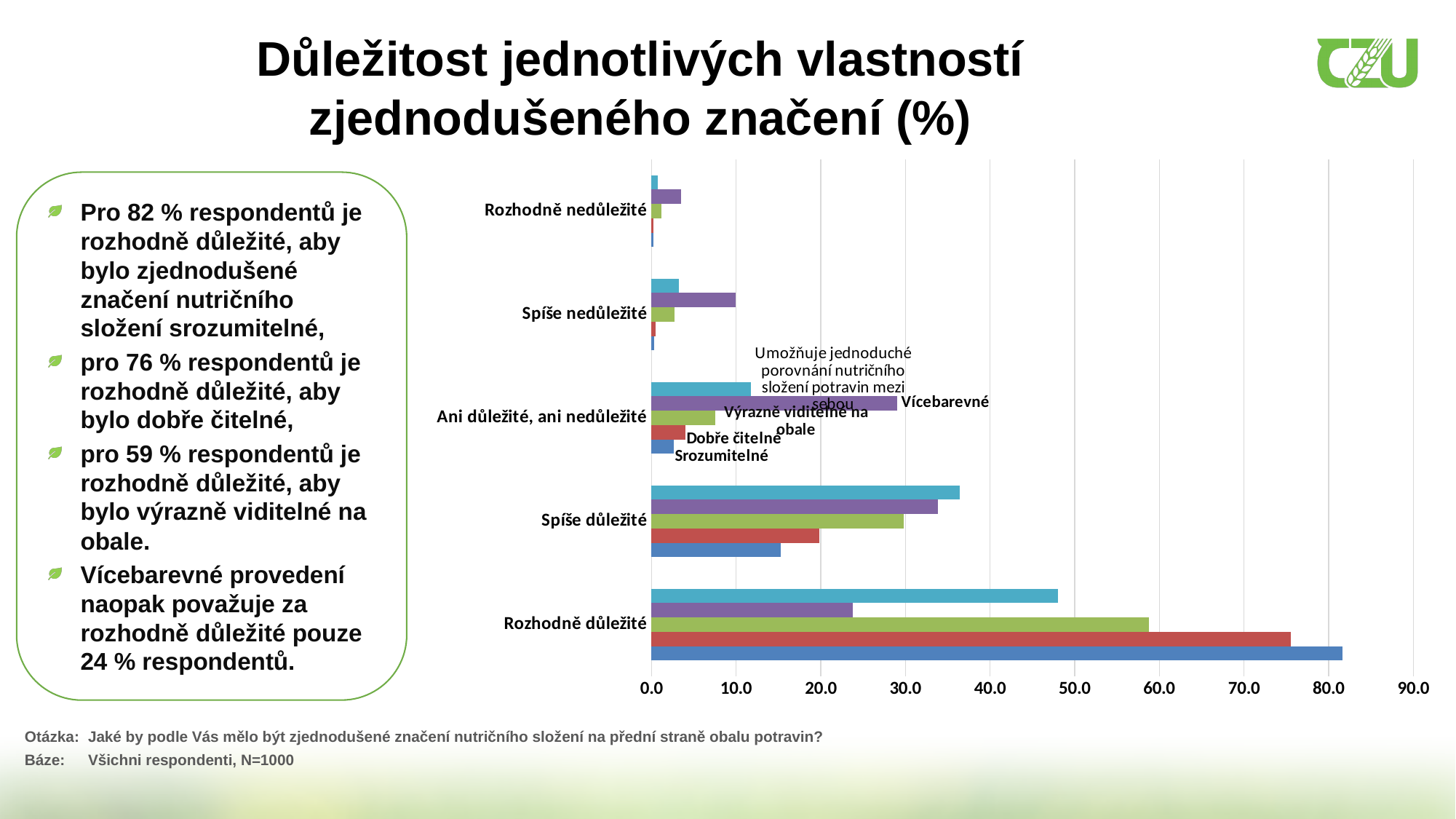
Is the value for 'Srozumitelné' in the 'Rozhodně důležité' category greater or less than 70.0? greater Is the value for 'Vícebarevné' in the 'Rozhodně důležité' category greater or less than 30.0? less In the 'Spíše důležité' category, which is larger: the value for 'Srozumitelné' or the value for 'Umožňuje jednoduché porovnání nutričního složení potravin mezi sebou'? Umožňuje jednoduché porovnání nutričního složení potravin mezi sebou Is the value for 'Výrazně viditelné na obale' in the 'Rozhodně důležité' category greater or less than 50.0? greater In the 'Rozhodně důležité' category, which series has the lowest value? Vícebarevné What is the maximum value shown on the horizontal axis of the chart? 90.0 In the 'Rozhodně důležité' category, which is larger: the value for 'Dobře čitelné' or the value for 'Výrazně viditelné na obale'? Dobře čitelné In the 'Rozhodně důležité' category, which series has the highest value? Srozumitelné What kind of chart is shown on the slide? bar chart How many categories are shown on the vertical axis of the chart? 5